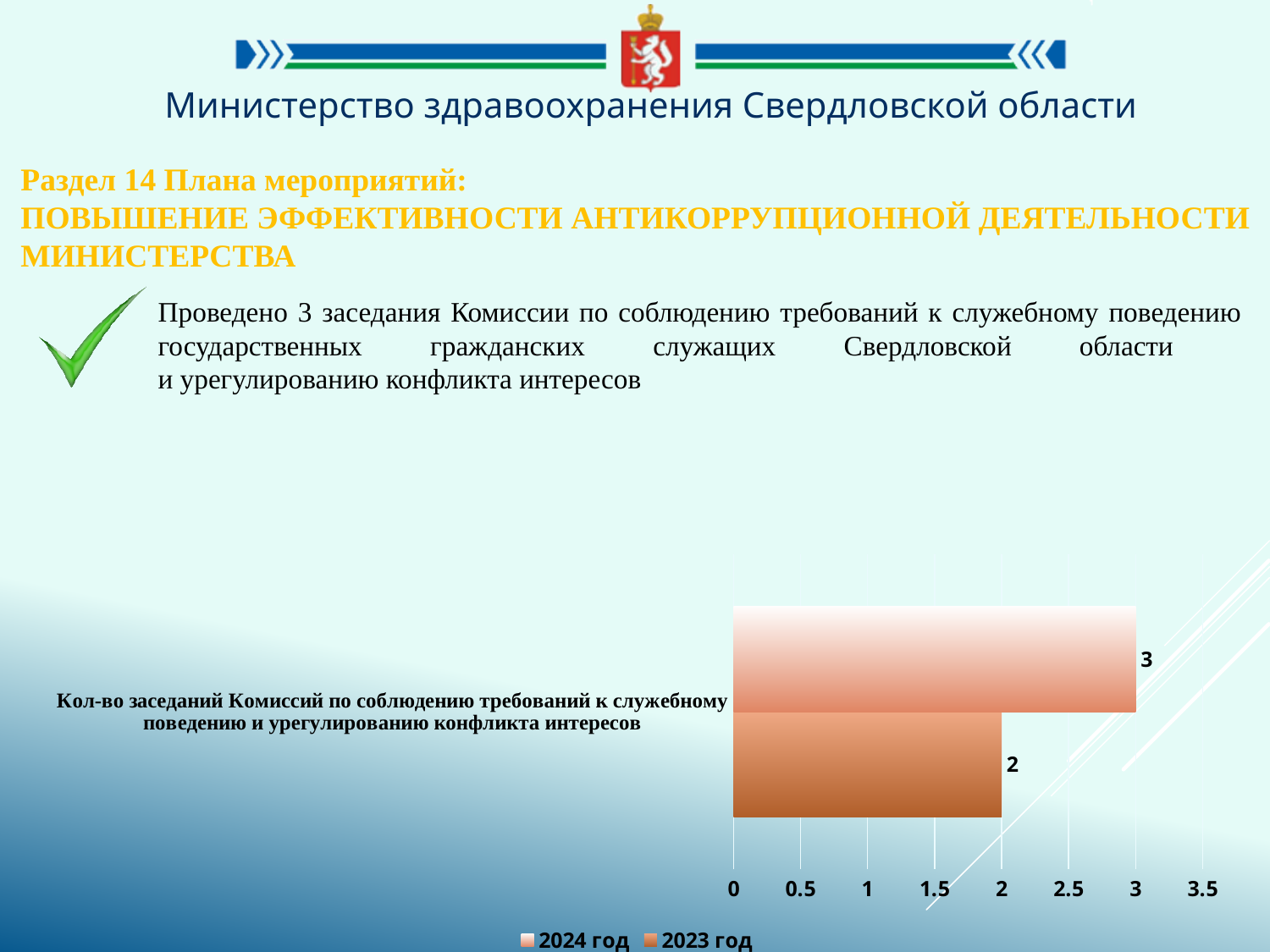
What is the value for 2023 год in the chart? 2 What type of chart is shown on the slide? bar chart Is the value for 2023 год greater or less than 2.5? less Which series has the highest value in the chart? 2024 год What is the category label shown on the chart? Кол-во заседаний Комиссий по соблюдению требований к служебному поведению и урегулированию конфликта интересов How many categories are shown on the chart's category axis? 1 Which series has the lowest value in the chart? 2023 год What is the value for 2024 год in the chart? 3 What is the difference between the values for 2024 год and 2023 год? 1 How many series does the legend list? 2 What is the maximum value shown on the chart's value axis? 3.5 Which series has the higher value, 2024 год or 2023 год? 2024 год